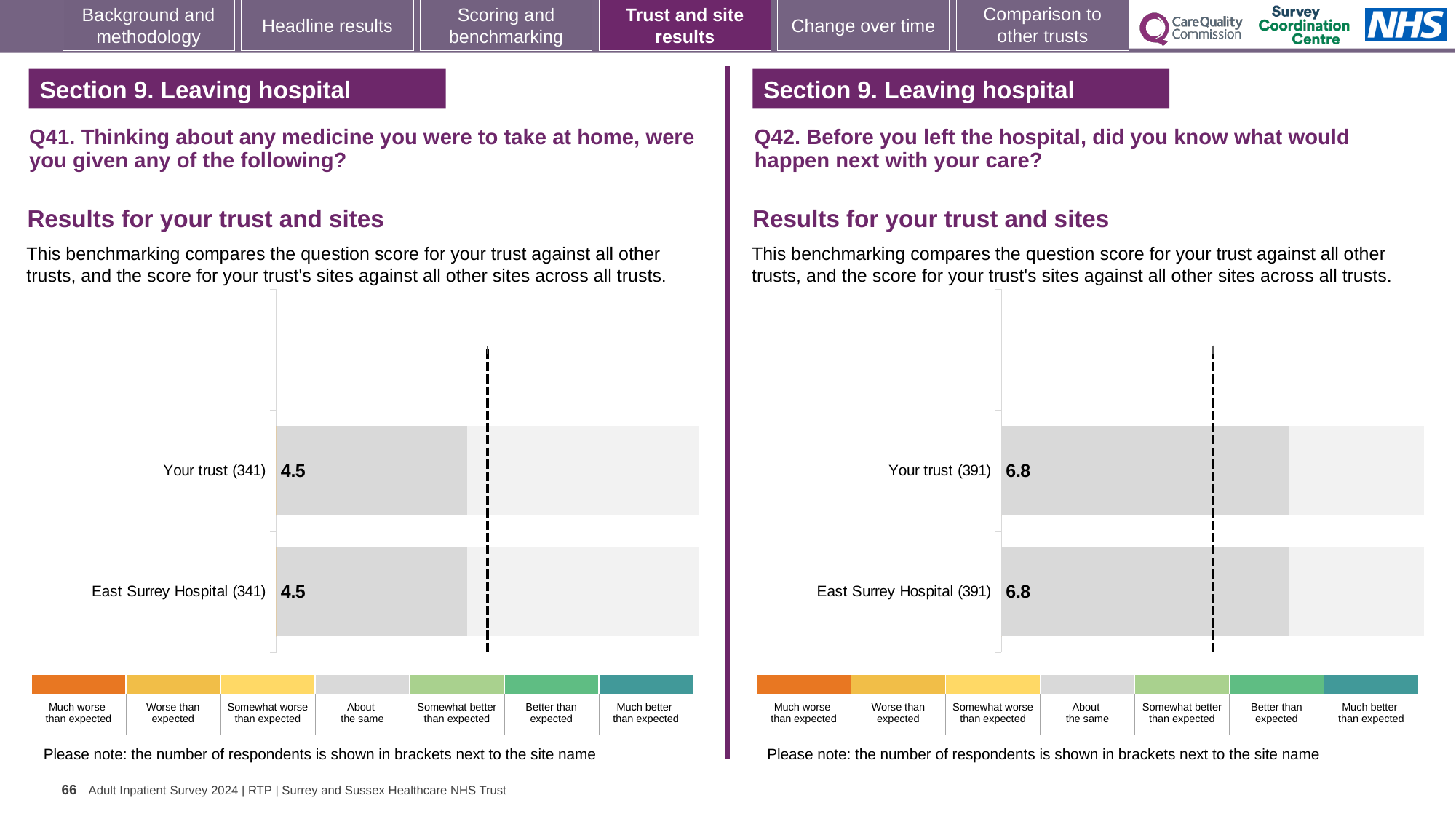
How many bars are plotted in the Q41 chart on the left? 2 In the Q41 chart on the left, what is the difference between the score for Your trust and the score for East Surrey Hospital? 0.0 In the Q41 chart on the left, how many respondents are shown in brackets next to Your trust? 341 How many bars are plotted in the Q42 chart on the right? 2 What kind of chart is the Q41 chart on the left? Bar chart In the Q42 chart on the right, what is the score for East Surrey Hospital? 6.8 In the Q41 chart on the left, what is the score for East Surrey Hospital? 4.5 In the Q42 chart on the right, what is the difference between the score for Your trust and the score for East Surrey Hospital? 0.0 Is the score for Your trust in the Q42 chart on the right larger than the score for Your trust in the Q41 chart on the left? Yes In the Q41 chart on the left, what is the score for Your trust? 4.5 In the Q42 chart on the right, what is the score for Your trust? 6.8 In the Q42 chart on the right, how many respondents are shown in brackets next to East Surrey Hospital? 391